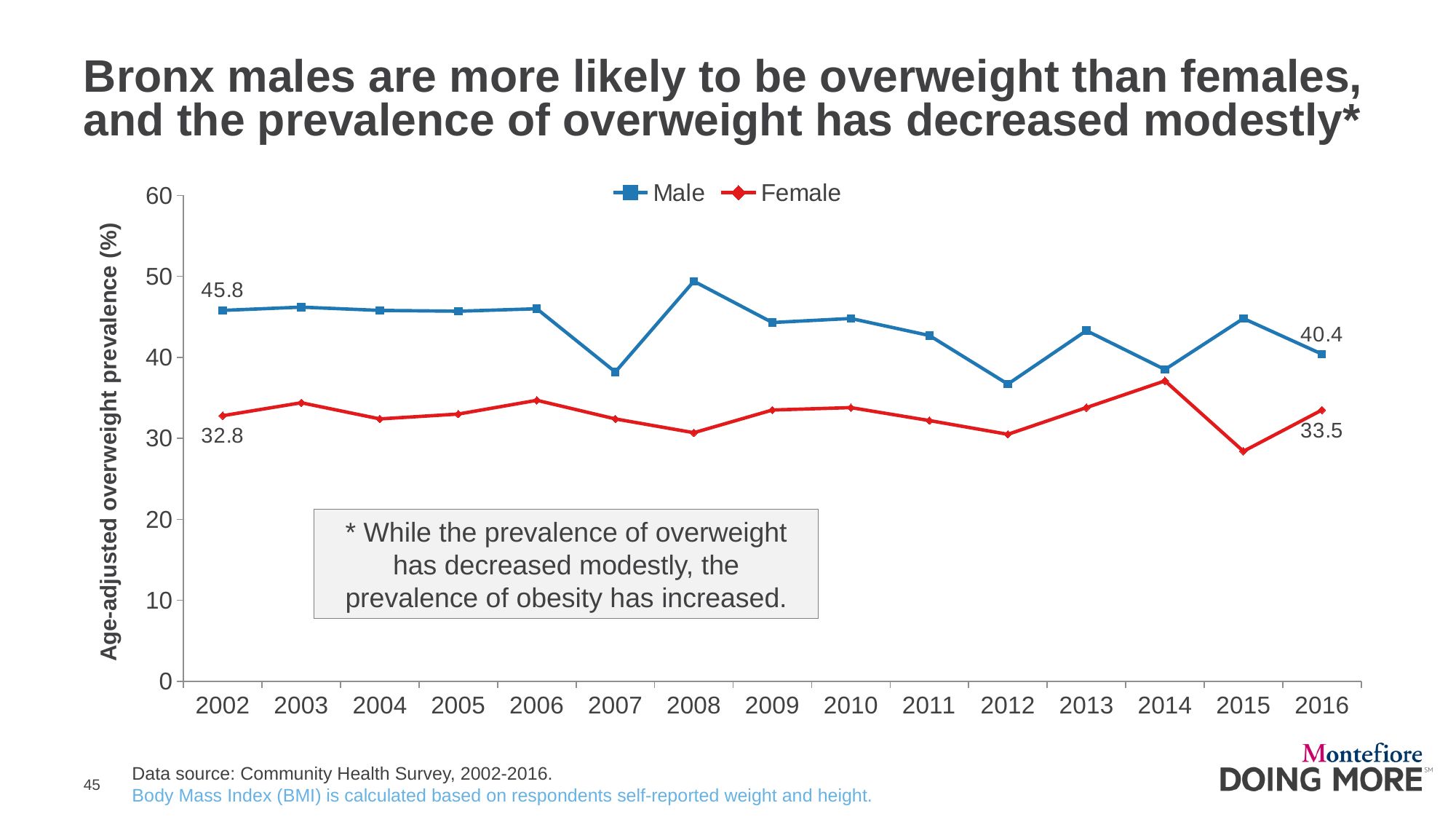
What is the age-adjusted overweight prevalence for Female in 2016? 33.5 Is the value for Male in 2012 greater or less than 40? less What is the age-adjusted overweight prevalence for Male in 2002? 45.8 What kind of chart is shown on the slide? line chart What is the age-adjusted overweight prevalence for Female in 2002? 32.8 In which year does the Male series reach its highest value? 2008 What is the age-adjusted overweight prevalence for Male in 2016? 40.4 In which year does the Female series reach its lowest value? 2015 Which series has the higher value in 2016, Male or Female? Male By how much did the Male overweight prevalence change from 2002 to 2016? 5.4 How many years are plotted on the x axis? 15 What is the difference between the Male and Female overweight prevalence in 2016? 6.9